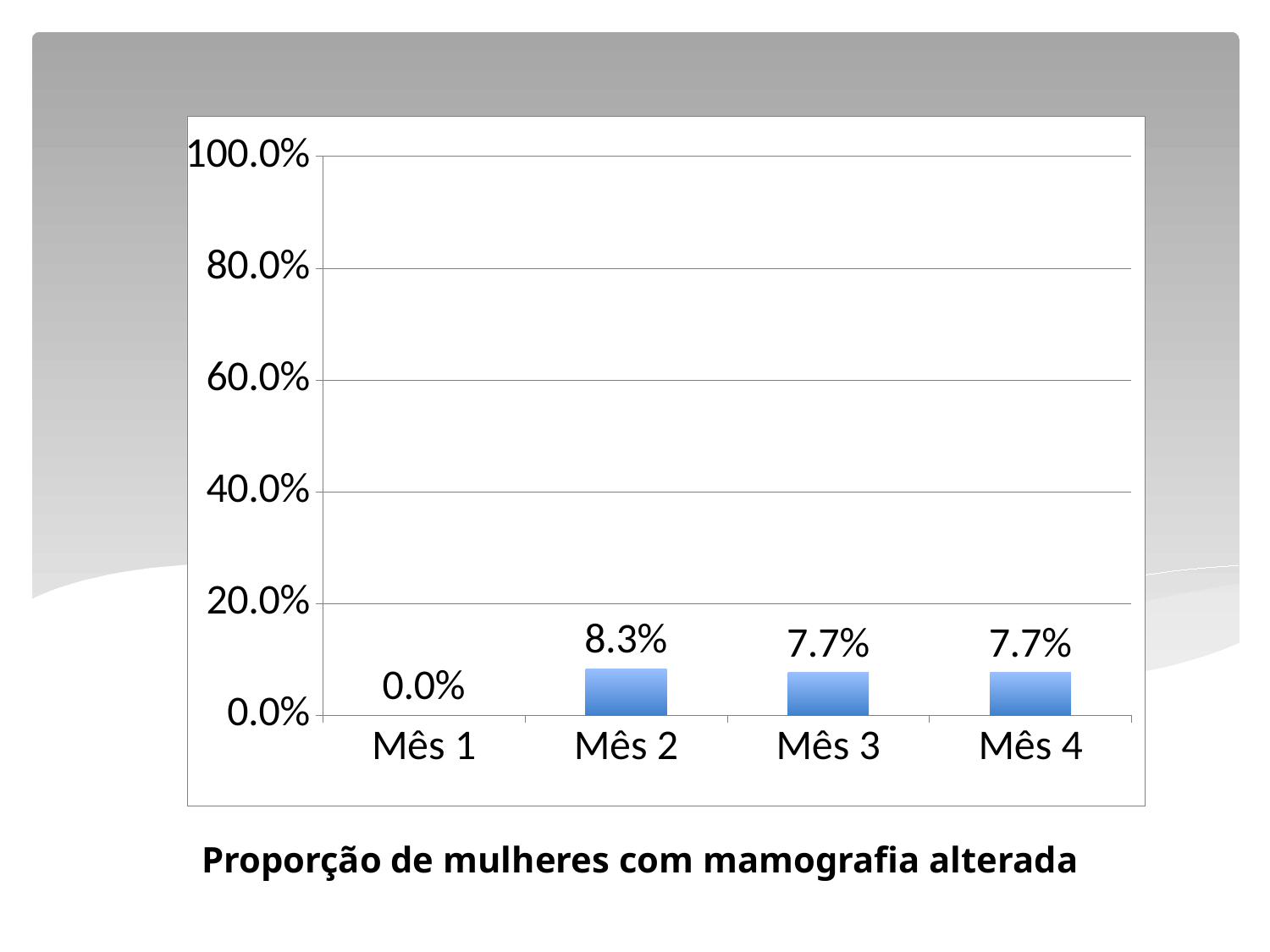
What kind of chart is shown on the slide? bar chart What is the value for Mês 1? 0.0% Which is larger, the value for Mês 2 or the value for Mês 4? Mês 2 Is the value for Mês 3 greater or less than 20.0%? less Which month has the highest value? Mês 2 What is the caption below the chart? Proporção de mulheres com mamografia alterada What is the difference between the values for Mês 2 and Mês 3? 0.6% What is the value for Mês 2? 8.3% How many months are shown on the x axis? 4 What is the value for Mês 4? 7.7% Which month has the lowest value? Mês 1 What is the highest value shown on the y axis? 100.0%